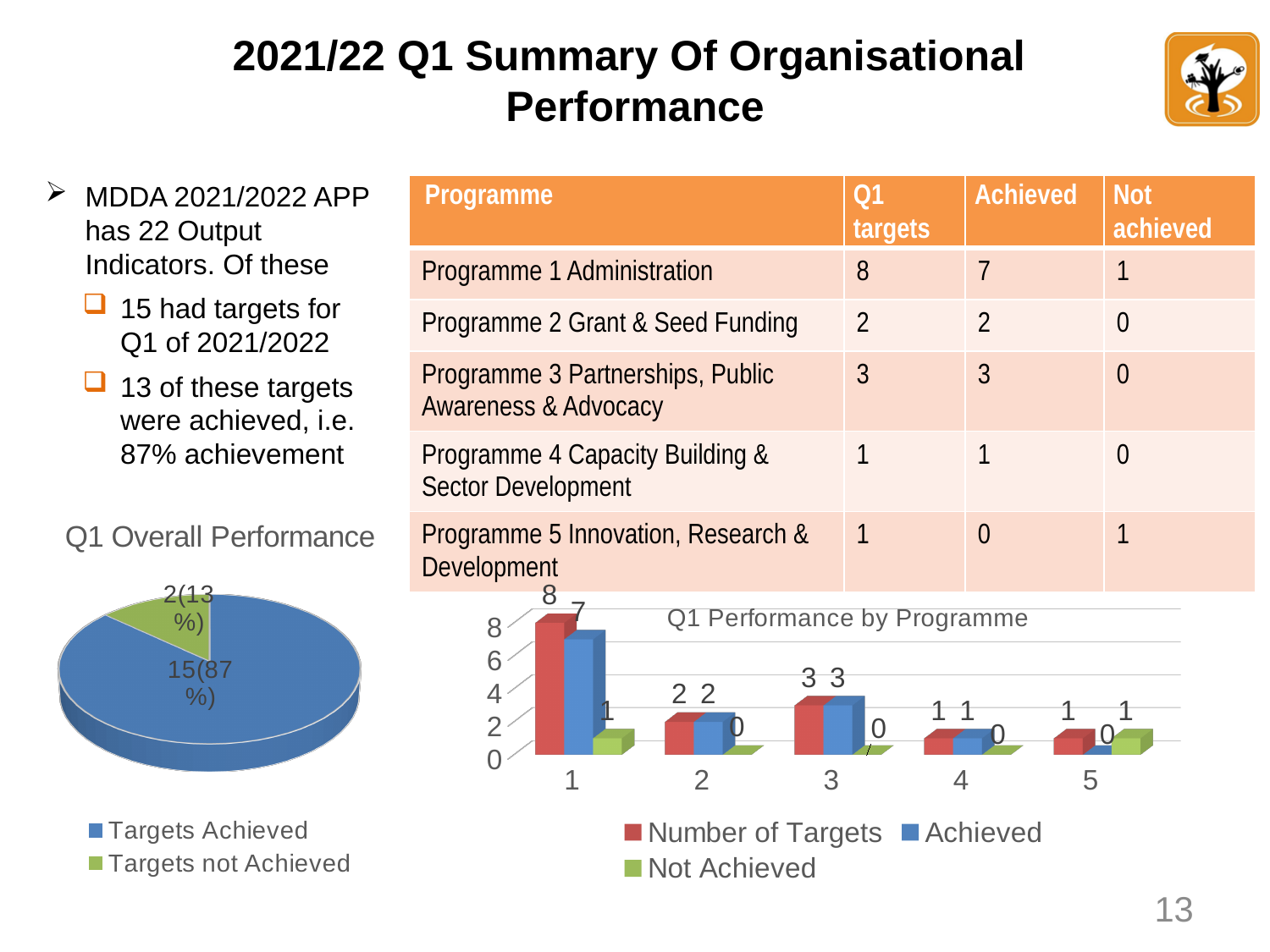
How many categories are shown on the x axis of the Q1 Performance by Programme chart? 5 What kind of chart is the Q1 Performance by Programme chart? Bar chart In the Q1 Performance by Programme chart, which is larger for category 3: Number of Targets or Not Achieved? Number of Targets In the Q1 Performance by Programme chart, what is the Achieved value for category 5? 0 In the Q1 Overall Performance pie chart, what share of the pie is Targets not Achieved? 13% How many entries does the legend of the Q1 Overall Performance chart list? 2 In the Q1 Performance by Programme chart, what is the difference between Number of Targets and Achieved for category 1? 1 In the Q1 Performance by Programme chart, what is the Number of Targets value for category 1? 8 How many series does the legend of the Q1 Performance by Programme chart list? 3 In the Q1 Overall Performance pie chart, what is the label shown for the Targets Achieved slice? 15(87%) What kind of chart is the Q1 Overall Performance chart? Pie chart In the Q1 Performance by Programme chart, which category has the highest Number of Targets? 1